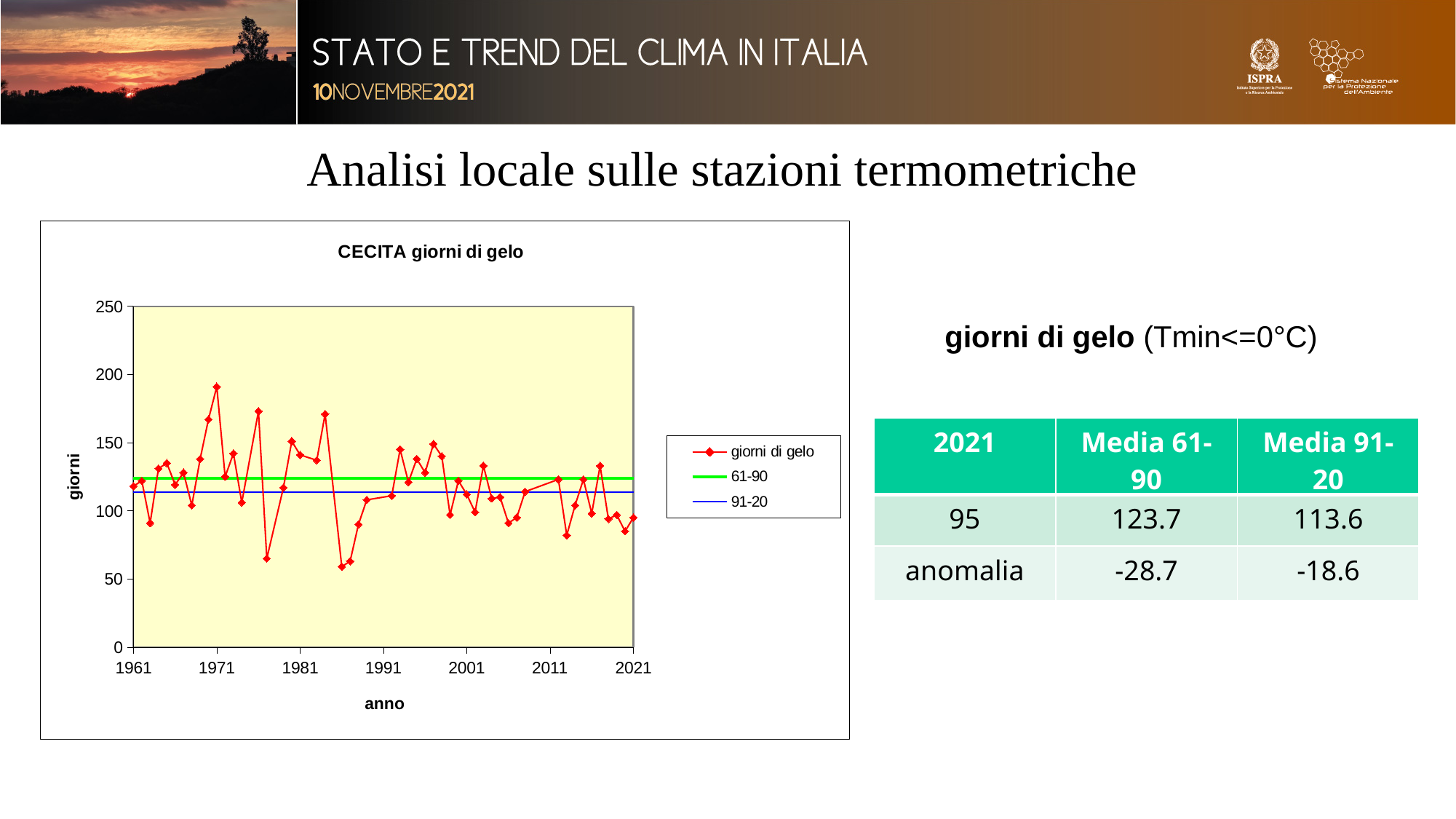
In the 'CECITA giorni di gelo' chart, is the value for 1971 greater or less than 150? greater In the 'CECITA giorni di gelo' chart, is the 61-90 reference line greater or less than 100? greater In the 'CECITA giorni di gelo' chart, which year has the highest number of giorni di gelo? 1971 In the 'CECITA giorni di gelo' chart, is the value for 2021 greater or less than 150? less How many series does the legend of the 'CECITA giorni di gelo' chart list? 3 What kind of chart is 'CECITA giorni di gelo'? line chart How many year labels are shown on the x axis of the 'CECITA giorni di gelo' chart? 7 In the 'CECITA giorni di gelo' chart, which year has the higher value, 1961 or 1971? 1971 According to the slide, how many giorni di gelo were recorded in 2021? 95 What is the label of the x axis of the 'CECITA giorni di gelo' chart? anno What is the title of the chart on the slide? CECITA giorni di gelo